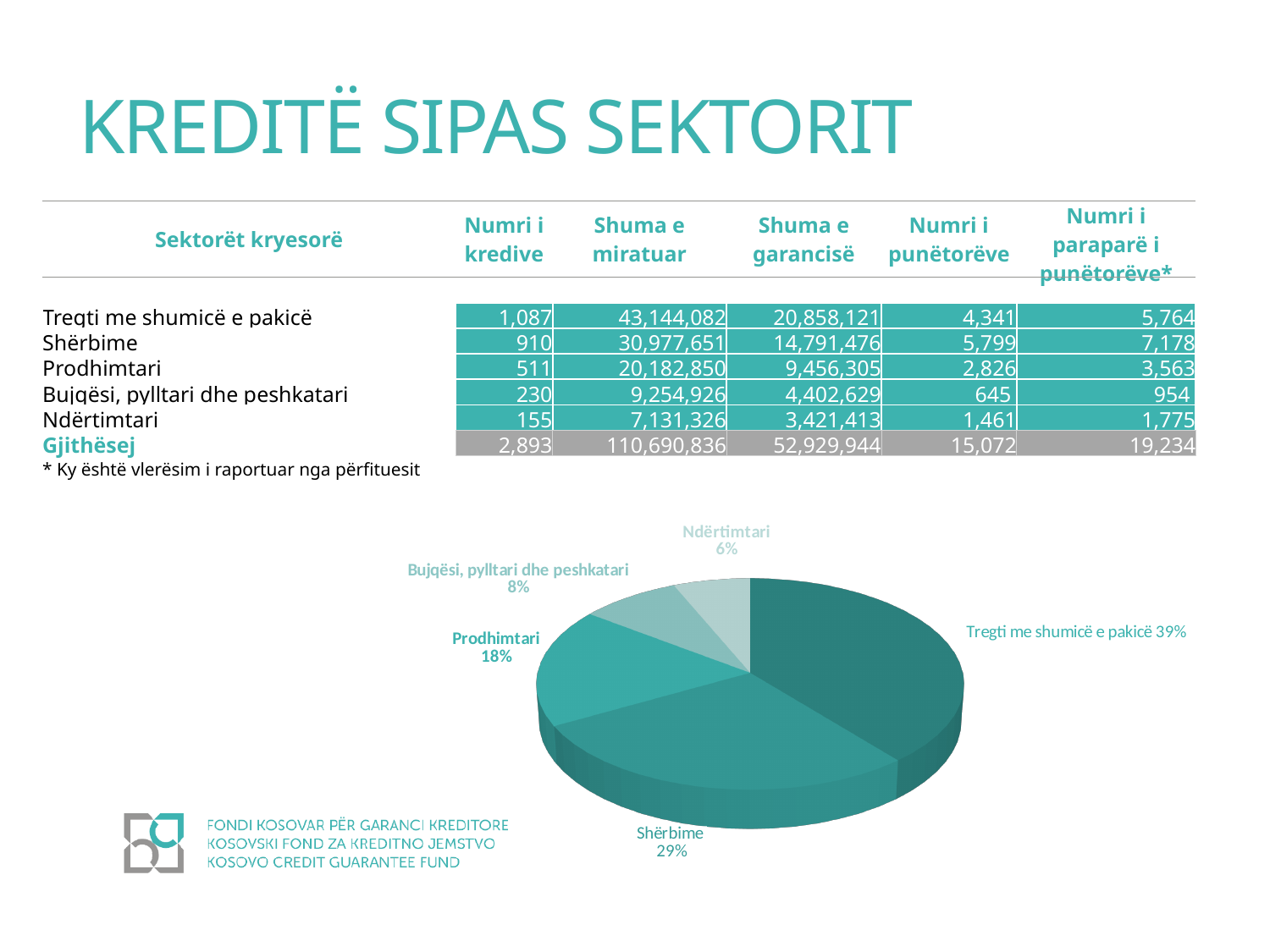
In the pie chart, what is the difference in percentage points between the Bujqësi, pylltari dhe peshkatari share and the Ndërtimtari share? 2 percentage points What share of the pie chart does Prodhimtari hold? 18% Which sector has the smallest slice in the pie chart? Ndërtimtari What share of the pie chart does Bujqësi, pylltari dhe peshkatari hold? 8% How many slices does the pie chart have? 5 What share of the pie chart does Ndërtimtari hold? 6% What kind of chart is shown on the slide? Pie chart In the pie chart, which is larger: the share for Shërbime or the share for Prodhimtari? Shërbime In the pie chart, what is the difference in percentage points between the Tregti me shumicë e pakicë share and the Shërbime share? 10 percentage points Which sector has the largest slice in the pie chart? Tregti me shumicë e pakicë